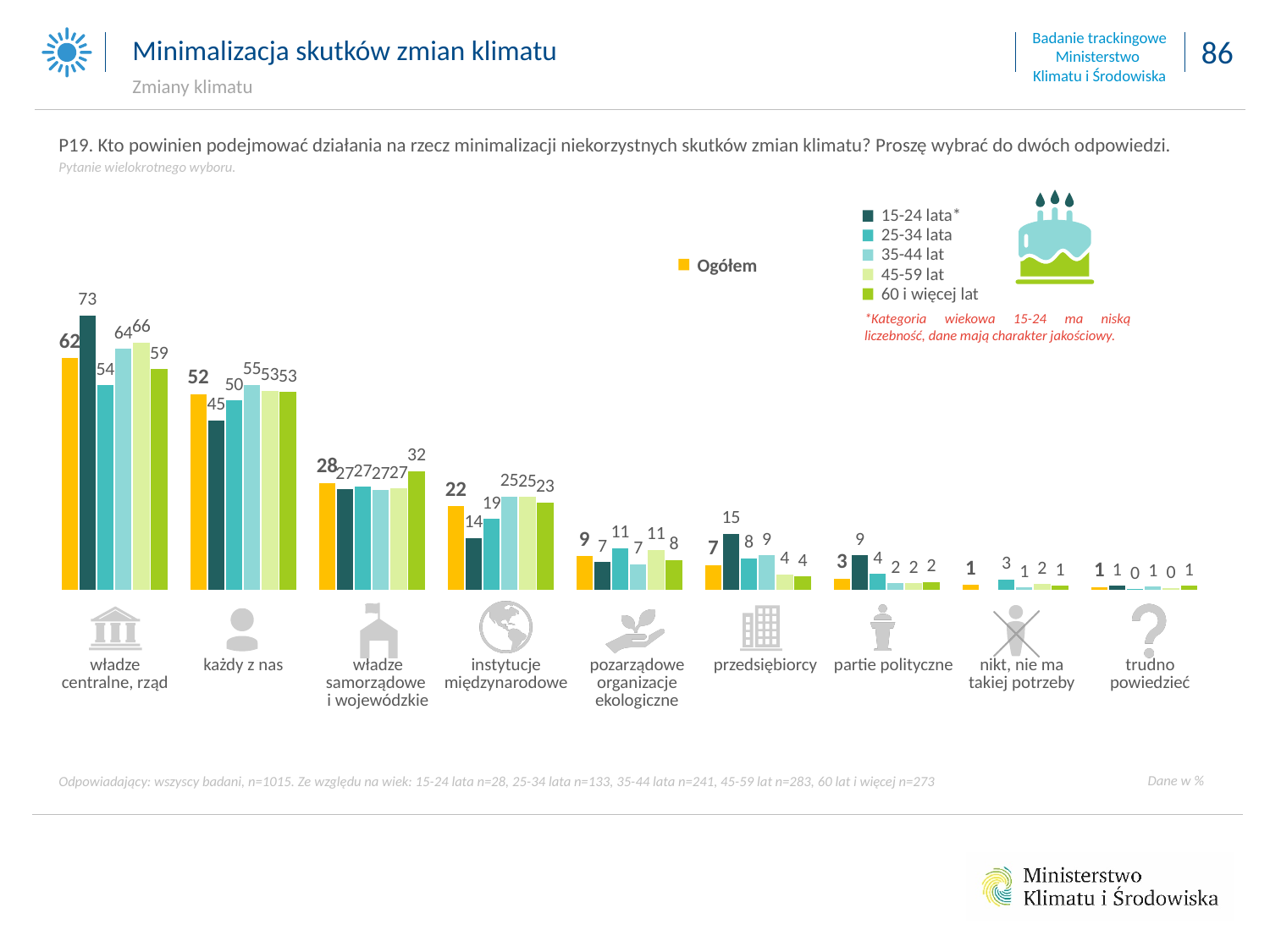
Which category has the highest Ogółem value? władze centralne, rząd What is the difference between the Ogółem values for 'władze centralne, rząd' and 'każdy z nas'? 10 What is the Ogółem value for 'instytucje międzynarodowe'? 22 For 'przedsiębiorcy', which is larger: the value for 15-24 lata or the value for 25-34 lata? 15-24 lata How many series does the legend list in total (including Ogółem)? 6 What is the value for the 15-24 lata group for 'władze centralne, rząd'? 73 How many answer categories are shown on the x axis? 9 What is the value for the 15-24 lata group for 'partie polityczne'? 9 What is the Ogółem value for 'władze centralne, rząd'? 62 Which age group has the lowest value for 'każdy z nas'? 15-24 lata What type of chart is shown on the slide? bar chart What is the value for the 60 i więcej lat group for 'władze samorządowe i wojewódzkie'? 32